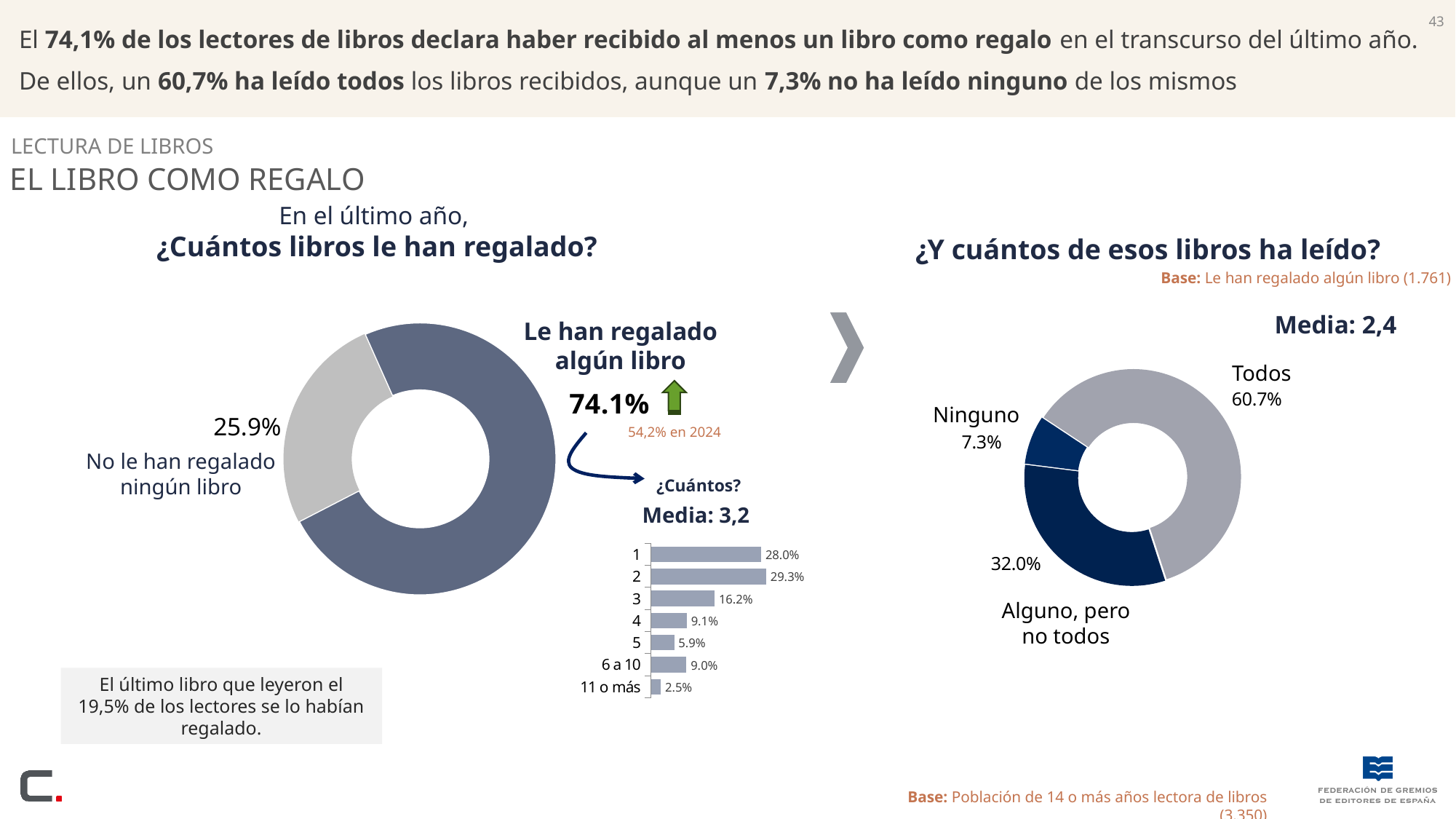
In the '¿Cuántos?' bar chart, which category has the highest value? 2 In the donut chart '¿Cuántos libros le han regalado?', what percentage of readers were given some book ('Le han regalado algún libro')? 74.1% In the donut chart '¿Cuántos libros le han regalado?', what percentage were not given any book ('No le han regalado ningún libro')? 25.9% In the donut chart '¿Y cuántos de esos libros ha leído?', what is the share for 'Alguno, pero no todos'? 32.0% In the '¿Cuántos?' bar chart, what is the difference between the values for '1' and '3'? 11.8% What kind of chart is the '¿Cuántos?' chart? Bar chart In the '¿Cuántos?' bar chart, what is the value for '11 o más'? 2.5% What is the 'Media' value shown above the donut chart '¿Y cuántos de esos libros ha leído?'? 2,4 In the '¿Cuántos?' bar chart, how many categories are shown? 7 In the '¿Cuántos?' bar chart, what is the value for category '2'? 29.3% In the donut chart '¿Y cuántos de esos libros ha leído?', which is larger: 'Todos' or 'Ninguno'? Todos In the '¿Cuántos?' bar chart, which category has the lowest value? 11 o más